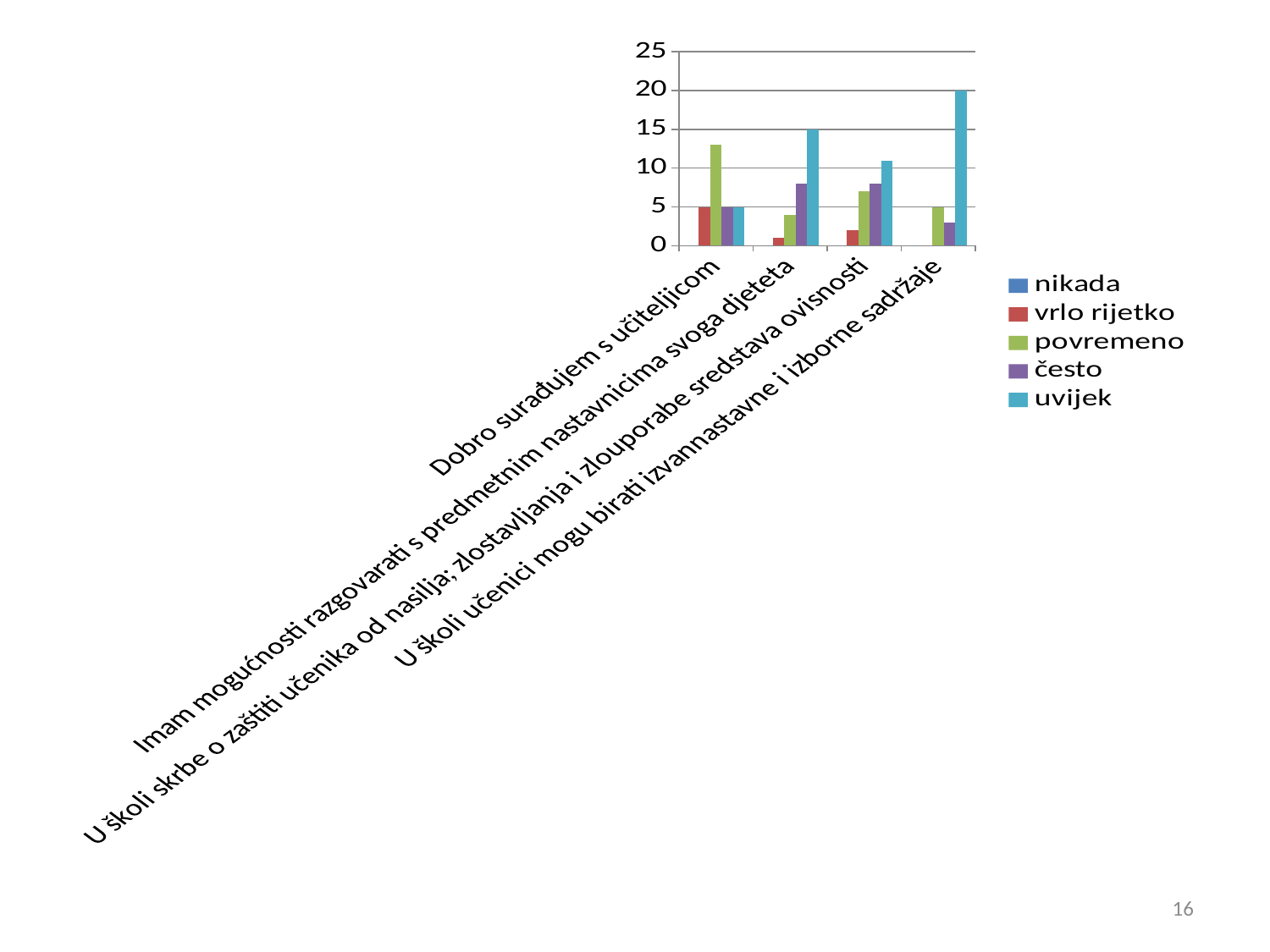
Which legend entry is shown in light blue? uvijek For which category is the 'uvijek' bar highest? U školi učenici mogu birati izvannastavne i izborne sadržaje What is the value of 'uvijek' for 'U školi učenici mogu birati izvannastavne i izborne sadržaje'? 20 What is the difference between the 'uvijek' values for 'U školi učenici mogu birati izvannastavne i izborne sadržaje' and 'Imam mogućnosti razgovarati s predmetnim nastavnicima svoga djeteta'? 5 What kind of chart is shown on the slide? bar chart What is the value of 'uvijek' for 'Imam mogućnosti razgovarati s predmetnim nastavnicima svoga djeteta'? 15 How many series does the legend list? 5 Which series has the highest bar for 'Dobro surađujem s učiteljicom'? povremeno Which is larger: the 'uvijek' value for 'U školi učenici mogu birati izvannastavne i izborne sadržaje' or for 'U školi skrbe o zaštiti učenika od nasilja, zlostavljanja i zlouporabe sredstava ovisnosti'? U školi učenici mogu birati izvannastavne i izborne sadržaje Is the value of 'često' for 'Imam mogućnosti razgovarati s predmetnim nastavnicima svoga djeteta' greater or less than 10? less Is the value of 'povremeno' for 'Dobro surađujem s učiteljicom' greater or less than 10? greater How many categories are shown on the x axis? 4